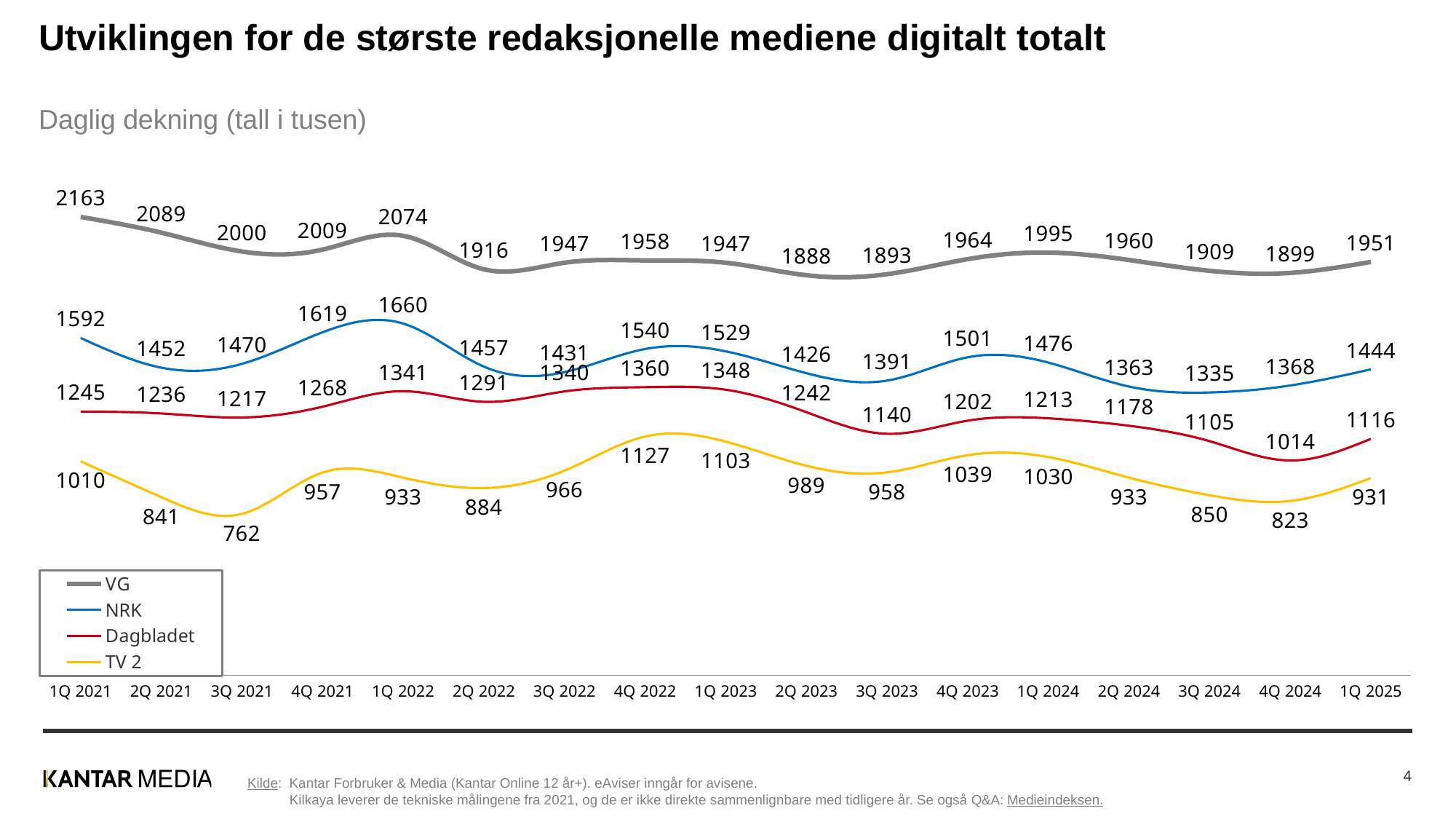
In which quarter does TV 2 have its lowest value? 3Q 2021 Which series is shown with a yellow line in the legend? TV 2 What kind of chart is shown on the slide? line chart What is the value for NRK in 1Q 2022? 1660 In which quarter does VG reach its highest value? 1Q 2021 What is the value for VG in 1Q 2025? 1951 What is the value for Dagbladet in 4Q 2024? 1014 What is the difference between VG and NRK in 1Q 2025? 507 How many quarters are plotted along the x axis? 17 How many series does the legend list? 4 What is the value for TV 2 in 3Q 2021? 762 Which series has the higher value in 4Q 2022, Dagbladet or TV 2? Dagbladet